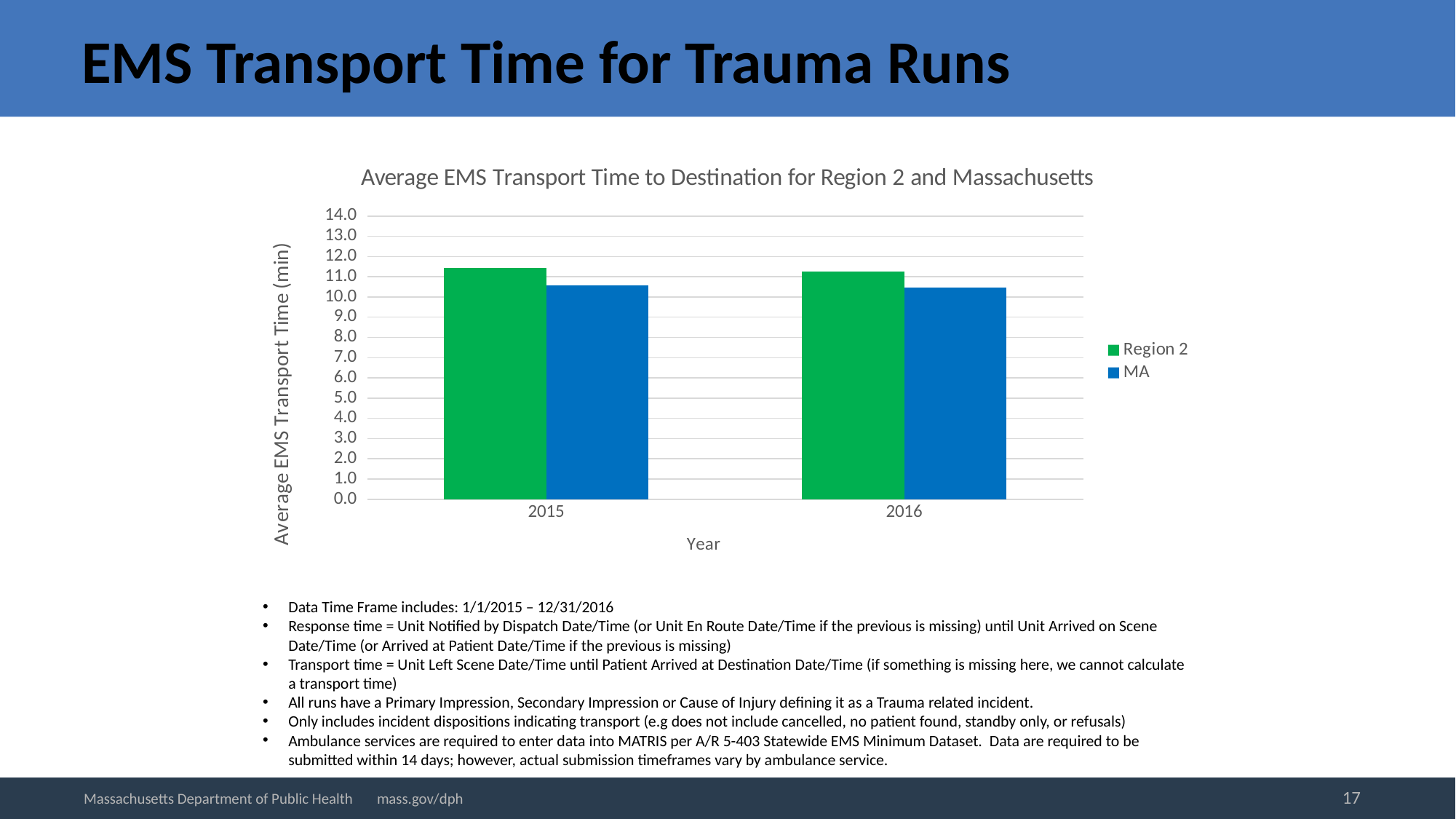
Is the value for Region 2 in 2016 greater or less than 10.0? greater Is the value for Region 2 in 2016 greater or less than 12.0? less Is the value for MA in 2015 greater or less than 11.0? less How many series does the legend list? 2 What is the title of the chart? Average EMS Transport Time to Destination for Region 2 and Massachusetts In 2015, which has the higher average EMS transport time, Region 2 or MA? Region 2 In 2016, which has the lower average EMS transport time, Region 2 or MA? MA How many years are shown on the x axis? 2 What kind of chart is shown on the slide? bar chart What is the label of the y axis? Average EMS Transport Time (min)